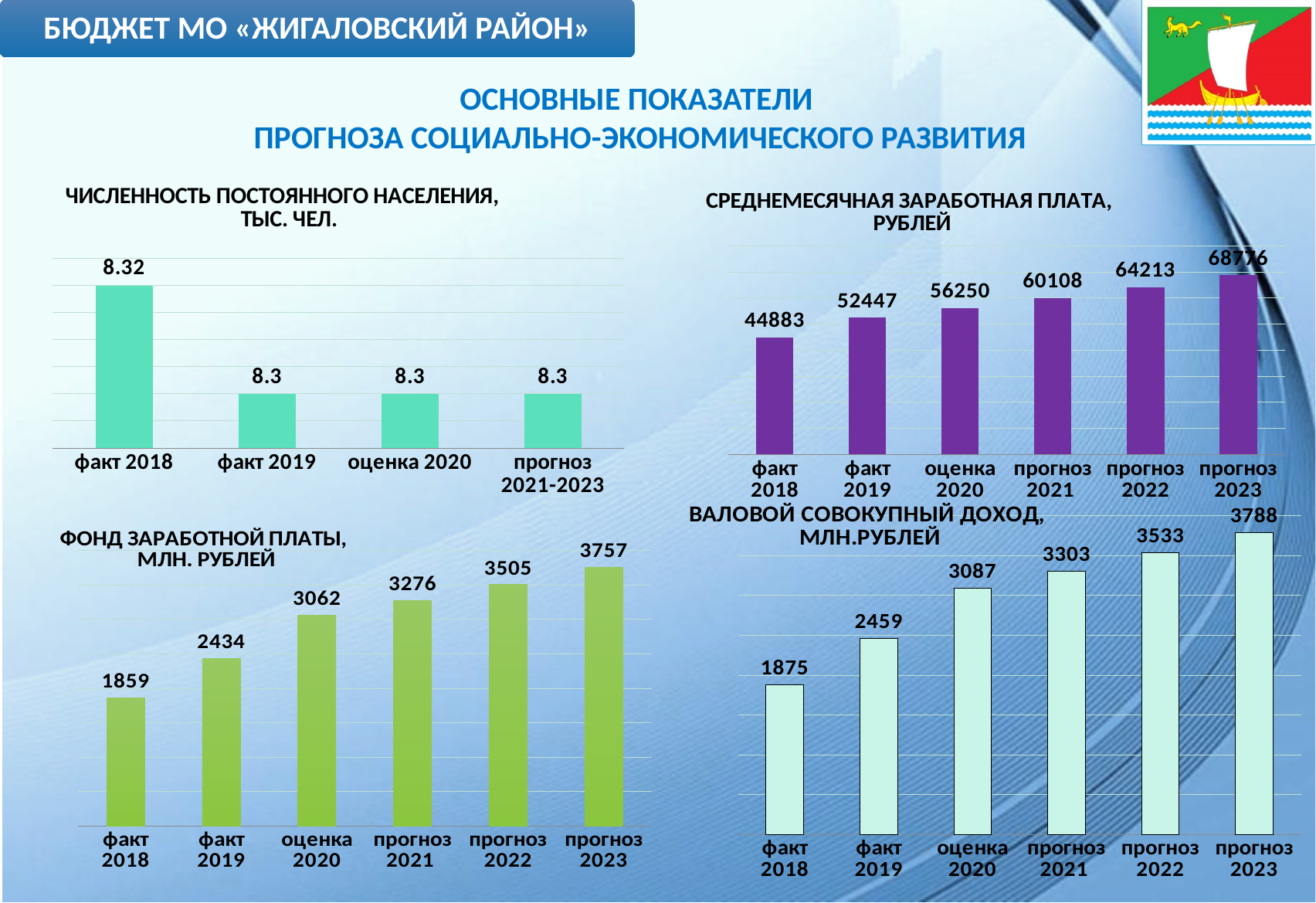
On the chart «Численность постоянного населения, тыс. чел.», what is the value for факт 2018? 8.32 How many categories are shown on the chart «Численность постоянного населения, тыс. чел.»? 4 On the chart «Фонд заработной платы, млн. рублей», which is larger: прогноз 2021 or оценка 2020? прогноз 2021 On the chart «Среднемесячная заработная плата, рублей», what is the difference between факт 2019 and факт 2018? 7564 On the chart «Среднемесячная заработная плата, рублей», which category has the lowest value? факт 2018 On the chart «Среднемесячная заработная плата, рублей», what is the value for прогноз 2023? 68776 On the chart «Валовой совокупный доход, млн.рублей», what is the value for оценка 2020? 3087 On the chart «Валовой совокупный доход, млн.рублей», what is the difference between прогноз 2023 and факт 2018? 1913 How many bars are shown on the chart «Валовой совокупный доход, млн.рублей»? 6 On the chart «Фонд заработной платы, млн. рублей», what is the value for факт 2019? 2434 What kind of chart is «Среднемесячная заработная плата, рублей»? bar chart On the chart «Фонд заработной платы, млн. рублей», which category has the highest value? прогноз 2023